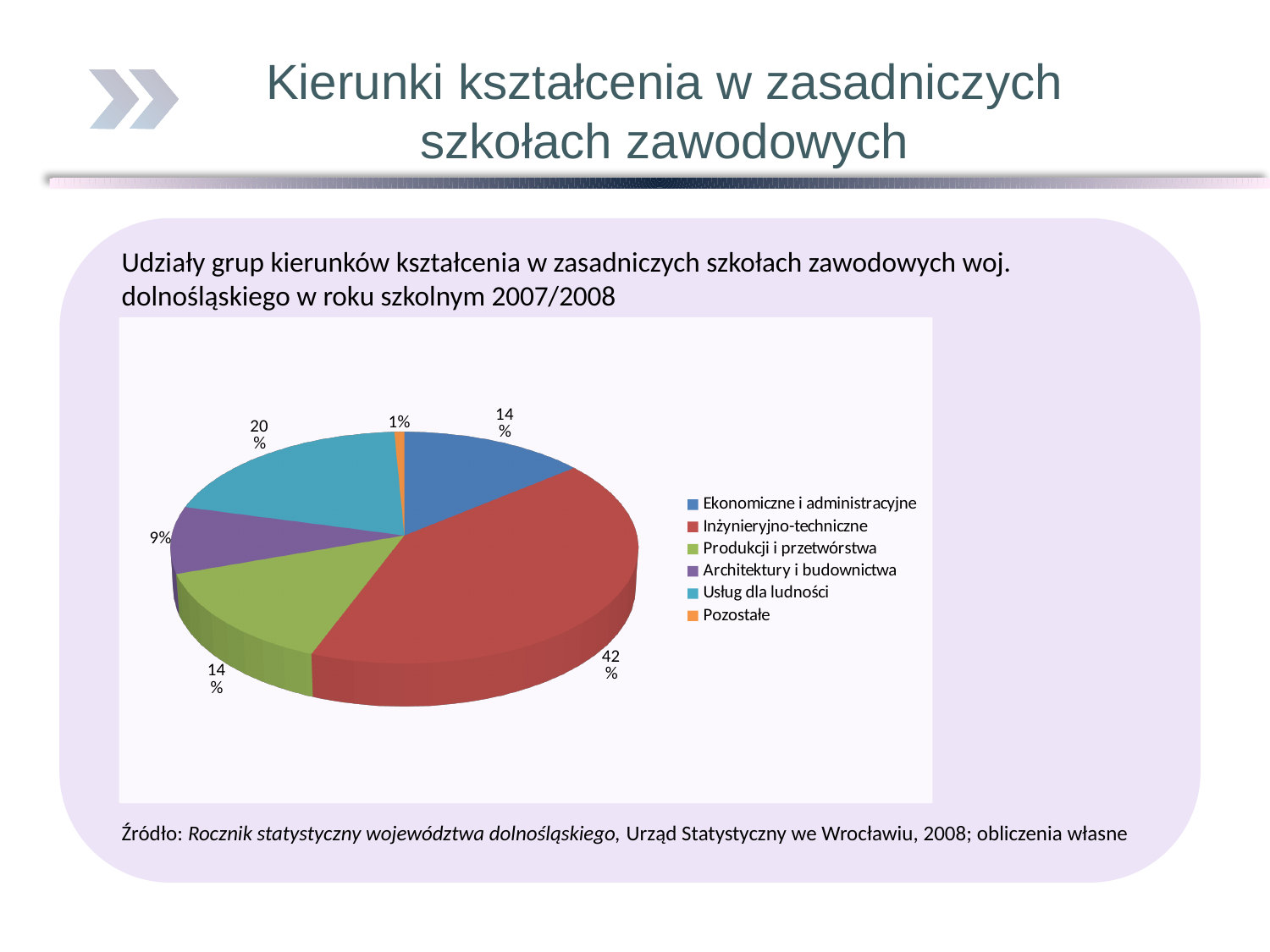
What share of the pie does Inżynieryjno-techniczne have? 42% Which category has the smallest share of the pie? Pozostałe Which colour represents Produkcji i przetwórstwa in the legend? green What share of the pie does Pozostałe have? 1% What share of the pie does Ekonomiczne i administracyjne have? 14% Which category has the largest share of the pie? Inżynieryjno-techniczne What is the difference in percentage points between Inżynieryjno-techniczne and Usług dla ludności? 22 Which is larger, the share for Usług dla ludności or the share for Architektury i budownictwa? Usług dla ludności What kind of chart is shown on the slide? pie chart How many categories does the pie chart show? 6